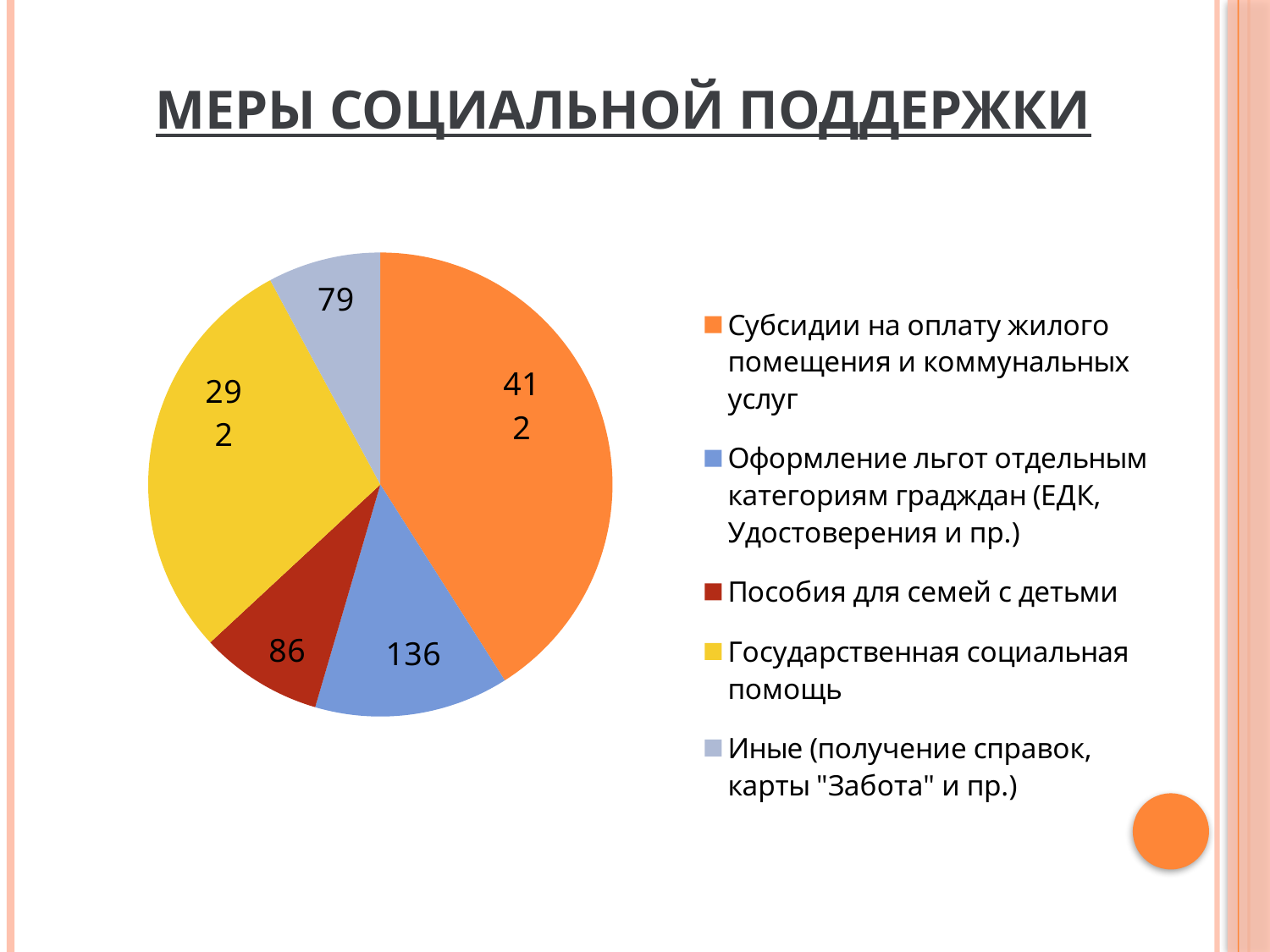
What is the value for "Субсидии на оплату жилого помещения и коммунальных услуг"? 412 What is the value for "Пособия для семей с детьми"? 86 What kind of chart is shown on the slide? Pie chart What colour is the slice for "Государственная социальная помощь"? Yellow Which category has the smallest slice of the pie? Иные (получение справок, карты "Забота" и пр.) Which is larger: the value for "Оформление льгот отдельным категориям гражждан" or the value for "Пособия для семей с детьми"? Оформление льгот отдельным категориям гражждан What is the total of all the values in the pie chart? 1005 What is the value for "Оформление льгот отдельным категориям гражждан (ЕДК, Удостоверения и пр.)"? 136 How many categories does the pie chart have? 5 What is the difference between the values for "Субсидии на оплату жилого помещения и коммунальных услуг" and "Государственная социальная помощь"? 120 What is the value for "Иные (получение справок, карты "Забота" и пр.)"? 79 Which category has the largest slice of the pie? Субсидии на оплату жилого помещения и коммунальных услуг